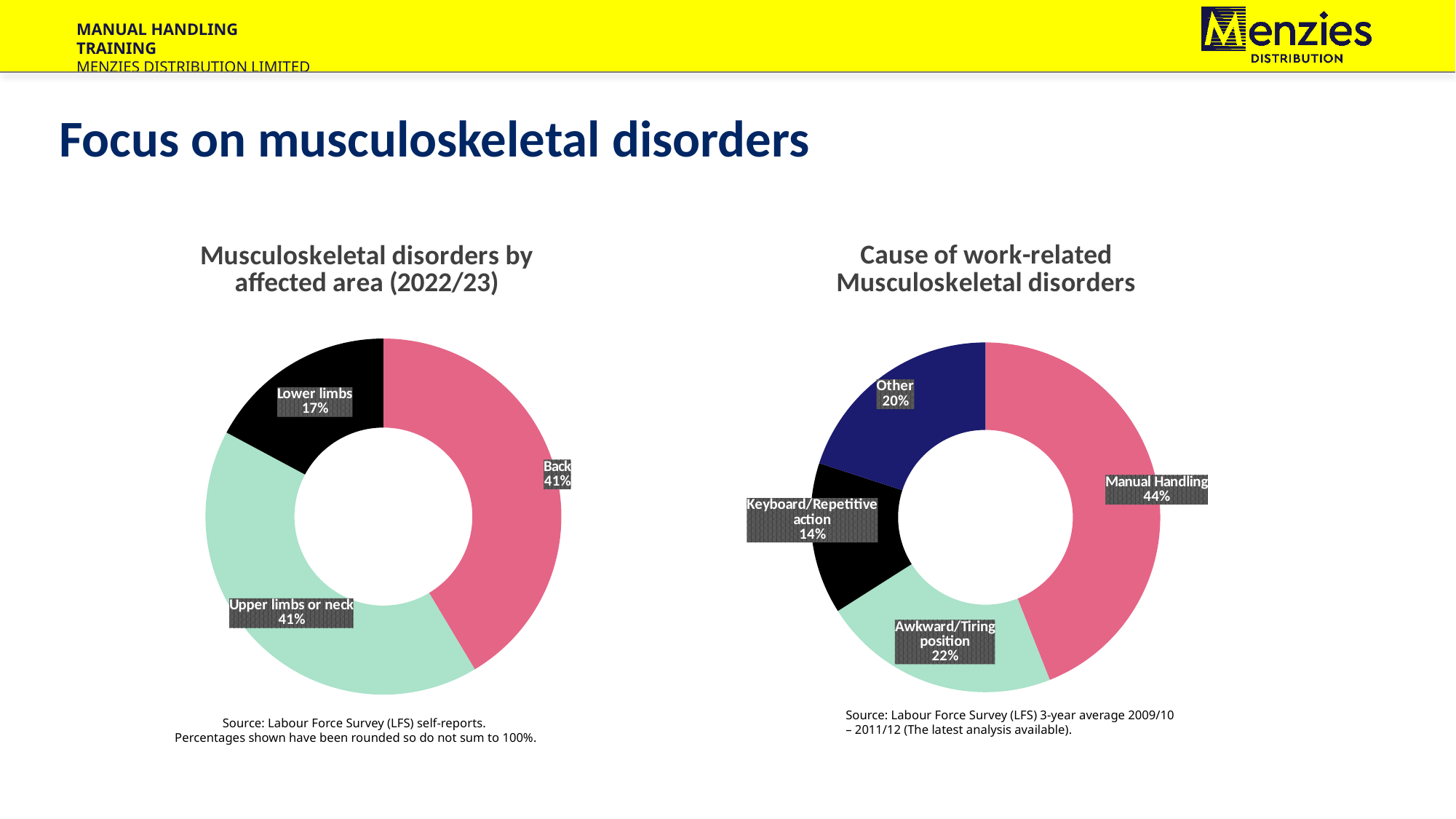
In the 'Cause of work-related Musculoskeletal disorders' chart, what percentage is attributed to Manual Handling? 44% In the 'Cause of work-related Musculoskeletal disorders' chart, how many causes are shown? 4 In the 'Musculoskeletal disorders by affected area (2022/23)' chart, what percentage is shown for Lower limbs? 17% In the 'Cause of work-related Musculoskeletal disorders' chart, which is larger: Awkward/Tiring position or Other? Awkward/Tiring position In the 'Musculoskeletal disorders by affected area (2022/23)' chart, what is the difference between the Back share and the Lower limbs share? 24 percentage points In the 'Cause of work-related Musculoskeletal disorders' chart, what percentage is attributed to Keyboard/Repetitive action? 14% What kind of chart is the 'Musculoskeletal disorders by affected area (2022/23)' chart? Doughnut (pie) chart In the 'Musculoskeletal disorders by affected area (2022/23)' chart, what percentage is shown for Back? 41% In the 'Cause of work-related Musculoskeletal disorders' chart, which cause has the largest share? Manual Handling In the 'Musculoskeletal disorders by affected area (2022/23)' chart, how many affected areas are shown? 3 In the 'Cause of work-related Musculoskeletal disorders' chart, what is the difference between the Manual Handling share and the Awkward/Tiring position share? 22 percentage points In the 'Musculoskeletal disorders by affected area (2022/23)' chart, which affected area has the smallest share? Lower limbs